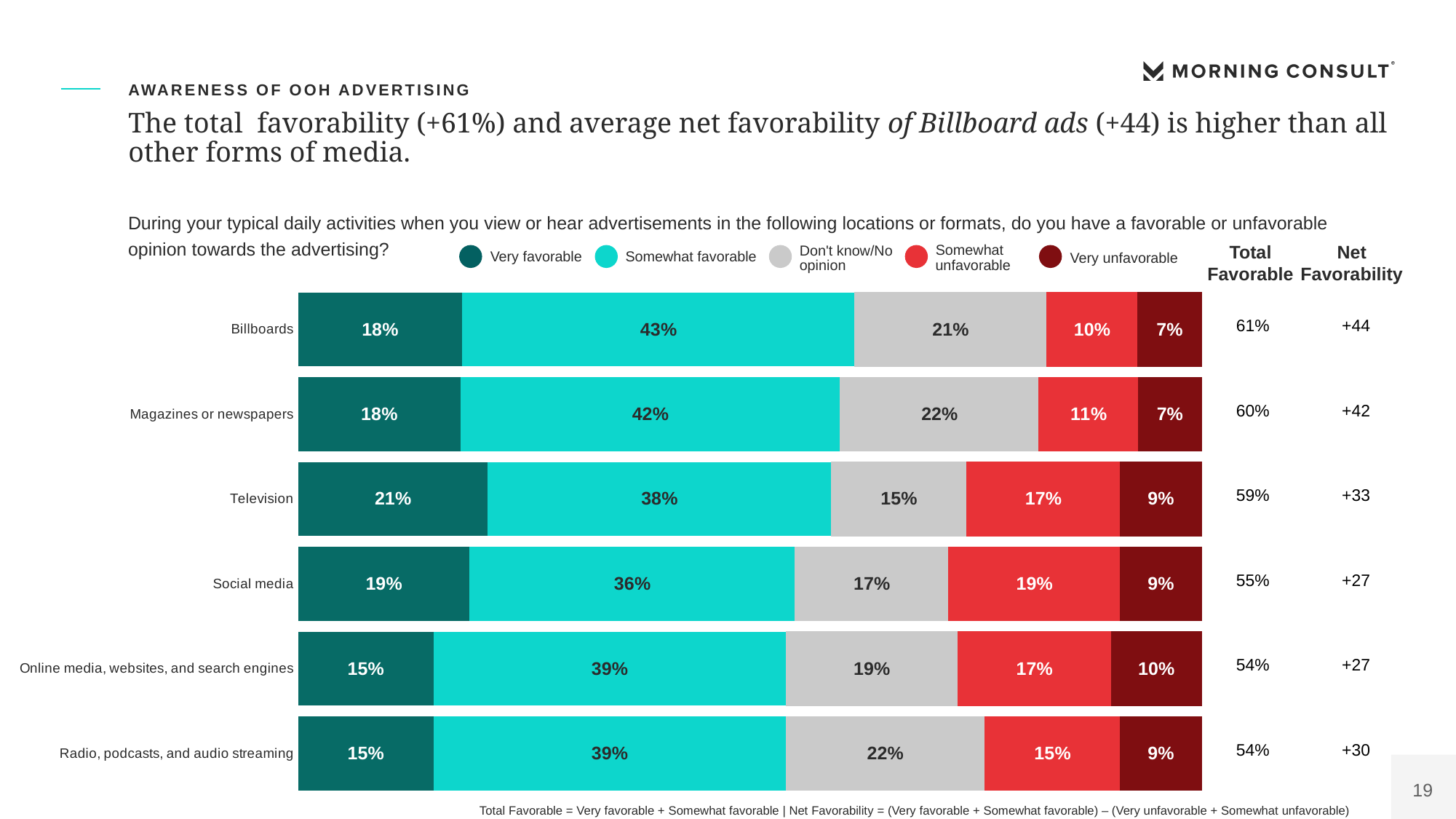
How many series does the legend list? 5 What is the total of 'Very favorable' and 'Somewhat favorable' for Magazines or newspapers? 60% What is the 'Don't know/No opinion' value for Radio, podcasts, and audio streaming? 22% What is the difference between the 'Somewhat favorable' values for Billboards and Social media? 7% Which is larger: the 'Very unfavorable' value for Online media, websites, and search engines or for Television? Online media, websites, and search engines What percentage of respondents are 'Very favorable' toward Television advertising? 21% What is the 'Somewhat favorable' value for Billboards? 43% Which category has the lowest 'Don't know/No opinion' value? Television Which category has the highest 'Somewhat unfavorable' value? Social media What kind of chart is shown on the slide? Stacked bar chart How many media categories are shown in the chart? 6 Which legend entry is shown in grey? Don't know/No opinion